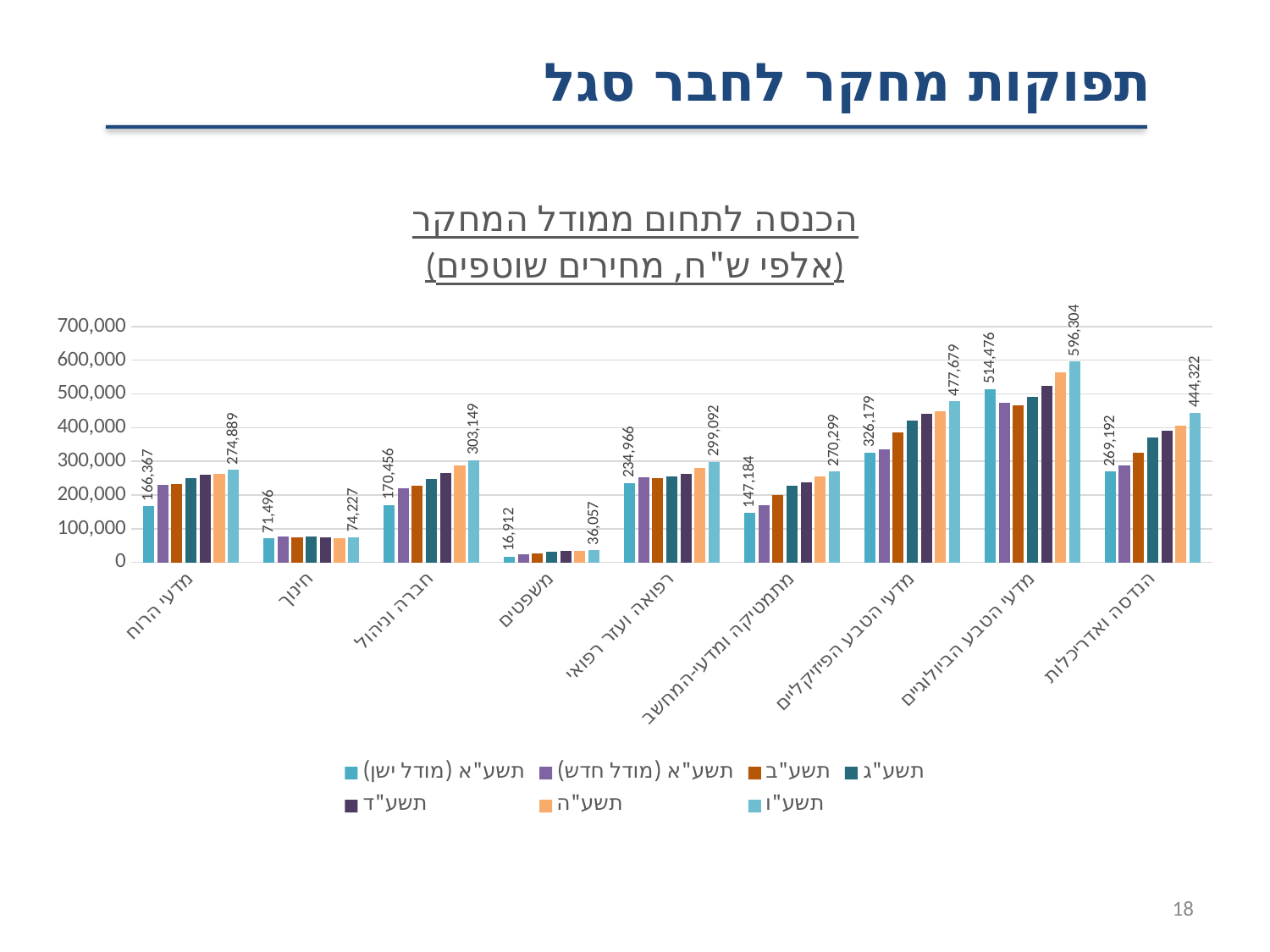
Which category has the highest value in the תשע"ו series? מדעי הטבע הביולוגיים What is the value for מדעי הטבע הביולוגיים in the תשע"ו series? 596,304 How many categories are shown on the x axis? 9 What is the difference between the תשע"ו and תשע"א (מודל ישן) values for חברה וניהול? 132,693 What is the value for הנדסה ואדריכלות in the תשע"ו series? 444,322 What kind of chart is shown on the slide? bar chart What is the title of the chart? הכנסה לתחום ממודל המחקר (אלפי ש"ח, מחירים שוטפים) Which category has the lowest value in the תשע"א (מודל ישן) series? משפטים How many series does the legend list? 7 What is the value for משפטים in the תשע"א (מודל ישן) series? 16,912 Is the תשע"ה value for מדעי הטבע הביולוגיים greater or less than 500,000? greater Which is larger: the תשע"ו value for מדעי הטבע הפיזיקליים or the תשע"ו value for הנדסה ואדריכלות? מדעי הטבע הפיזיקליים